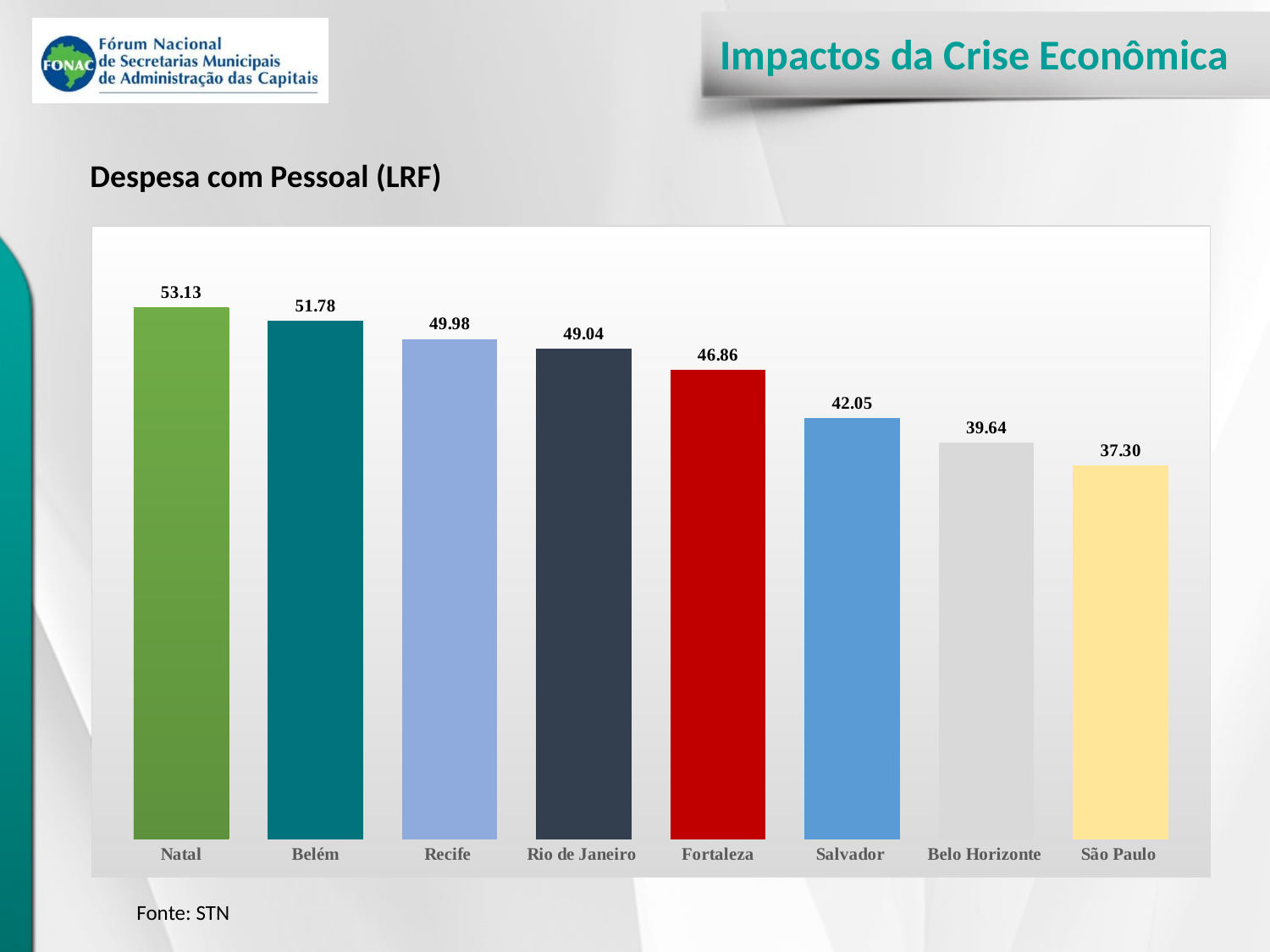
What is the difference between the values for Natal and São Paulo? 15.83 Which city has the highest value? Natal What kind of chart is shown on the slide? Bar chart What is the value for Belo Horizonte? 39.64 Do the values rise or fall from left to right across the cities? Fall How many cities are shown in the chart? 8 Which is larger, the value for Recife or the value for Salvador? Recife What is the title of the chart? Despesa com Pessoal (LRF) Which city has the lowest value? São Paulo What is the value for Fortaleza? 46.86 What is the difference between the values for Belém and Salvador? 9.73 What is the value for Natal? 53.13